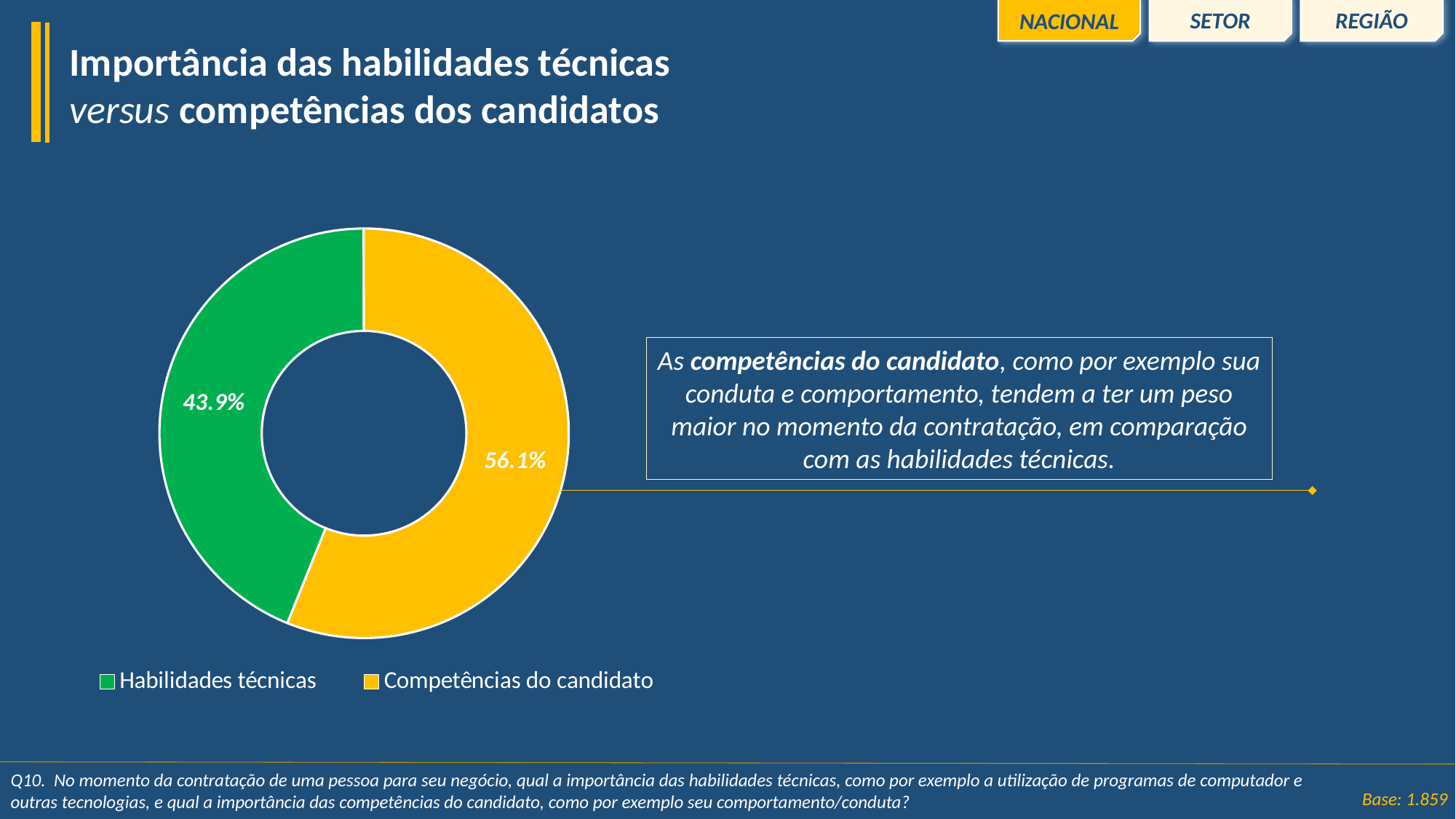
Which category has the smaller share of the chart? Habilidades técnicas Which category has the larger share of the chart? Competências do candidato Which is larger: the share for Habilidades técnicas or the share for Competências do candidato? Competências do candidato Which colour represents Habilidades técnicas in the chart? Green What is the difference in percentage points between Competências do candidato and Habilidades técnicas? 12.2 What percentage is shown for Competências do candidato? 56.1% How many categories does the chart show? 2 What percentage is shown for Habilidades técnicas? 43.9% What kind of chart is shown on the slide? Pie chart (doughnut) What is the total of the two slices shown in the chart? 100% Which colour represents Competências do candidato in the chart? Yellow How many entries does the legend list? 2